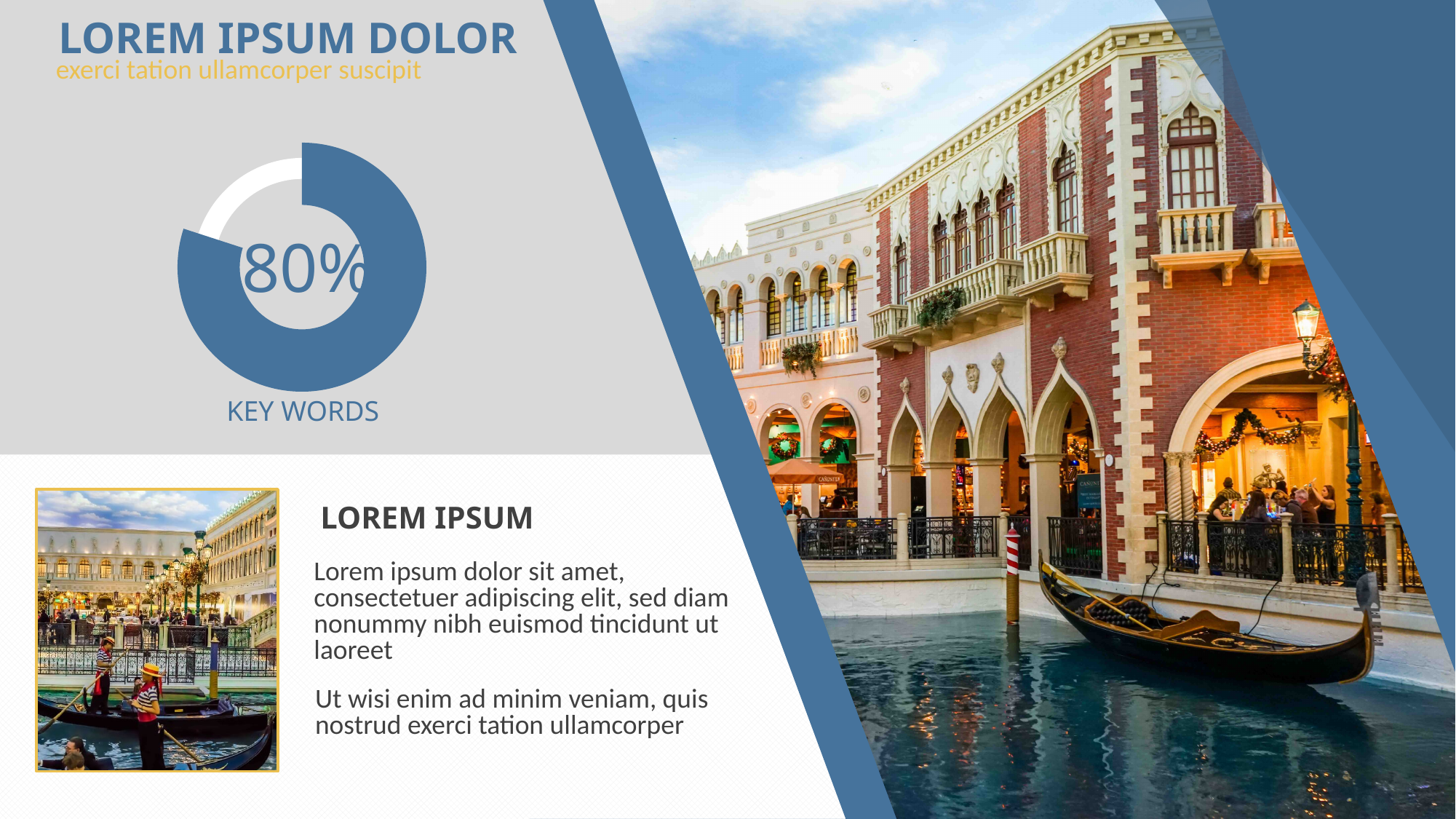
What colour is the filled 80% segment of the doughnut chart? blue What label appears directly below the doughnut chart? KEY WORDS How many segments does the doughnut chart have? 2 Is the value shown in the doughnut chart greater or less than 90%? less What percentage is displayed in the centre of the doughnut chart? 80% What kind of chart is shown on the left of the slide? doughnut chart Is the value shown in the doughnut chart greater or less than 50%? greater Which segment of the doughnut chart is larger, the blue one or the white one? the blue one What share of the doughnut chart is not filled in blue? 20%